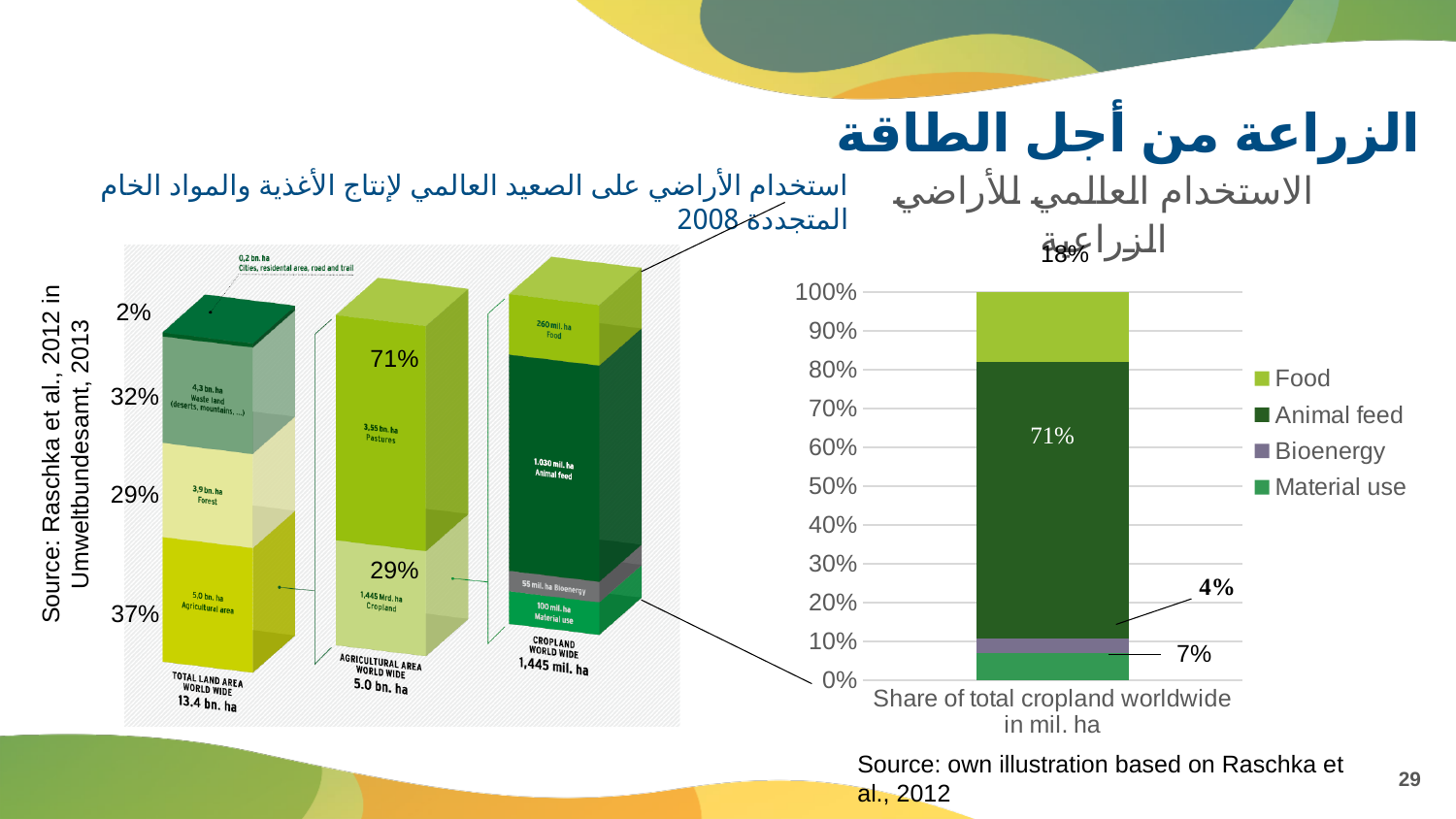
In the stacked bar chart on the right, which category has the largest share of cropland? Animal feed In the stacked bar chart on the right, which category has the smallest share of cropland? Bioenergy How many series does the legend of the stacked bar chart on the right list? 4 What type of chart is shown on the right side of the slide? Stacked bar chart In the stacked bar chart on the right, what percentage is labelled for Food? 18% In the stacked bar chart on the right (Share of total cropland worldwide), what percentage is labelled for Animal feed? 71% What is the axis title shown below the stacked bar chart on the right? Share of total cropland worldwide in mil. ha In the stacked bar chart on the right, what is the difference between the Animal feed share and the Food share? 53% In the stacked bar chart on the right, what is the total of all four segments of the bar? 100% In the stacked bar chart on the right, what percentage is labelled for Bioenergy? 4% In the stacked bar chart on the right, which is larger, the share for Material use or the share for Bioenergy? Material use In the stacked bar chart on the right, what percentage is labelled for Material use? 7%